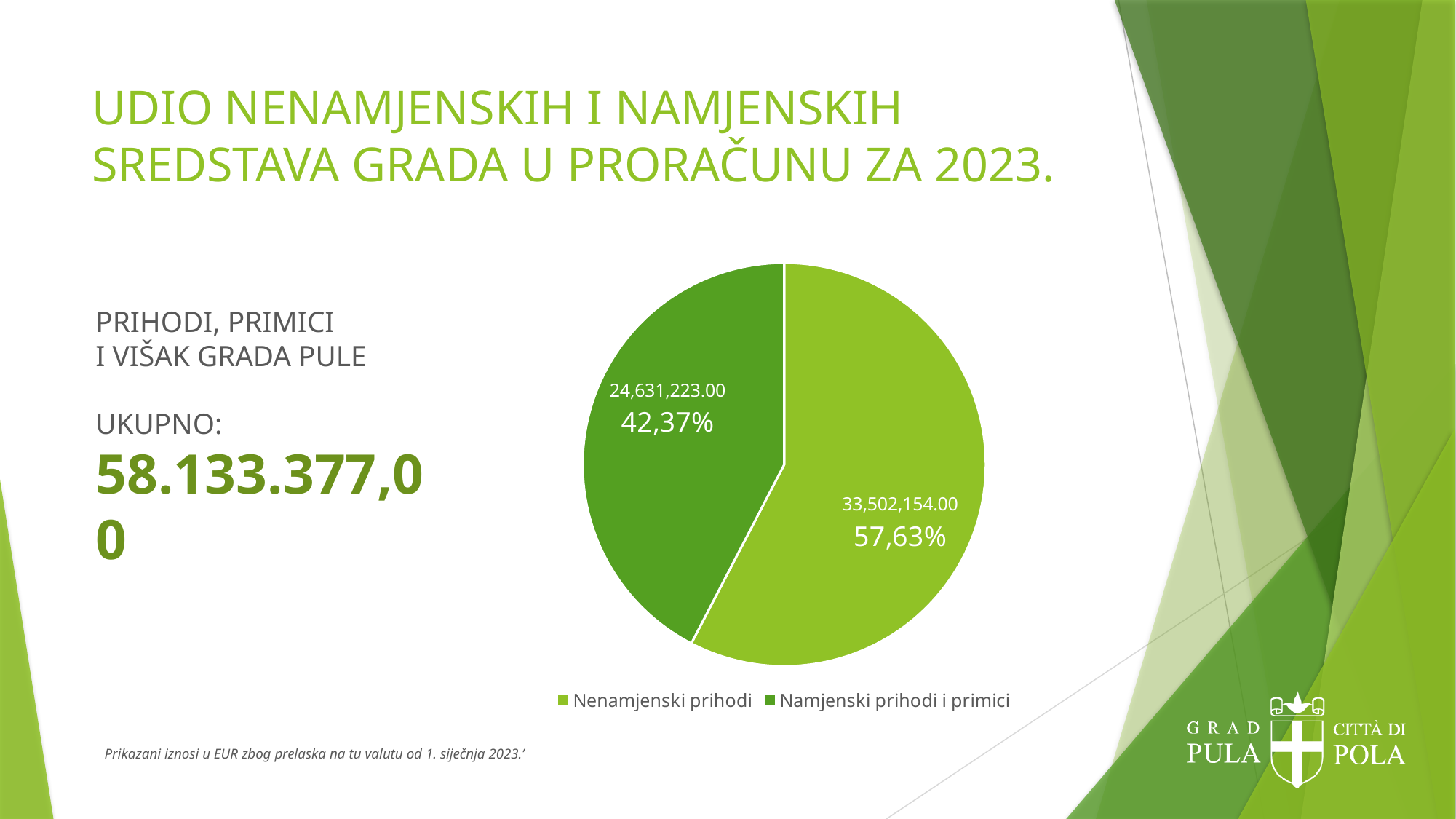
How many slices does the pie chart have? 2 What is the difference between the values for Nenamjenski prihodi and Namjenski prihodi i primici? 8,870,931.00 Which legend entry is shown in the darker green colour? Namjenski prihodi i primici What share of the pie does Nenamjenski prihodi represent? 57,63% What is the value shown for Nenamjenski prihodi in the pie chart? 33,502,154.00 What share of the pie does Namjenski prihodi i primici represent? 42,37% Which is larger in the pie chart, Nenamjenski prihodi or Namjenski prihodi i primici? Nenamjenski prihodi Which slice of the pie chart is the smallest? Namjenski prihodi i primici How many entries does the legend of the pie chart list? 2 What kind of chart is shown on the slide? pie chart What is the value shown for Namjenski prihodi i primici in the pie chart? 24,631,223.00 Which slice of the pie chart is the largest? Nenamjenski prihodi